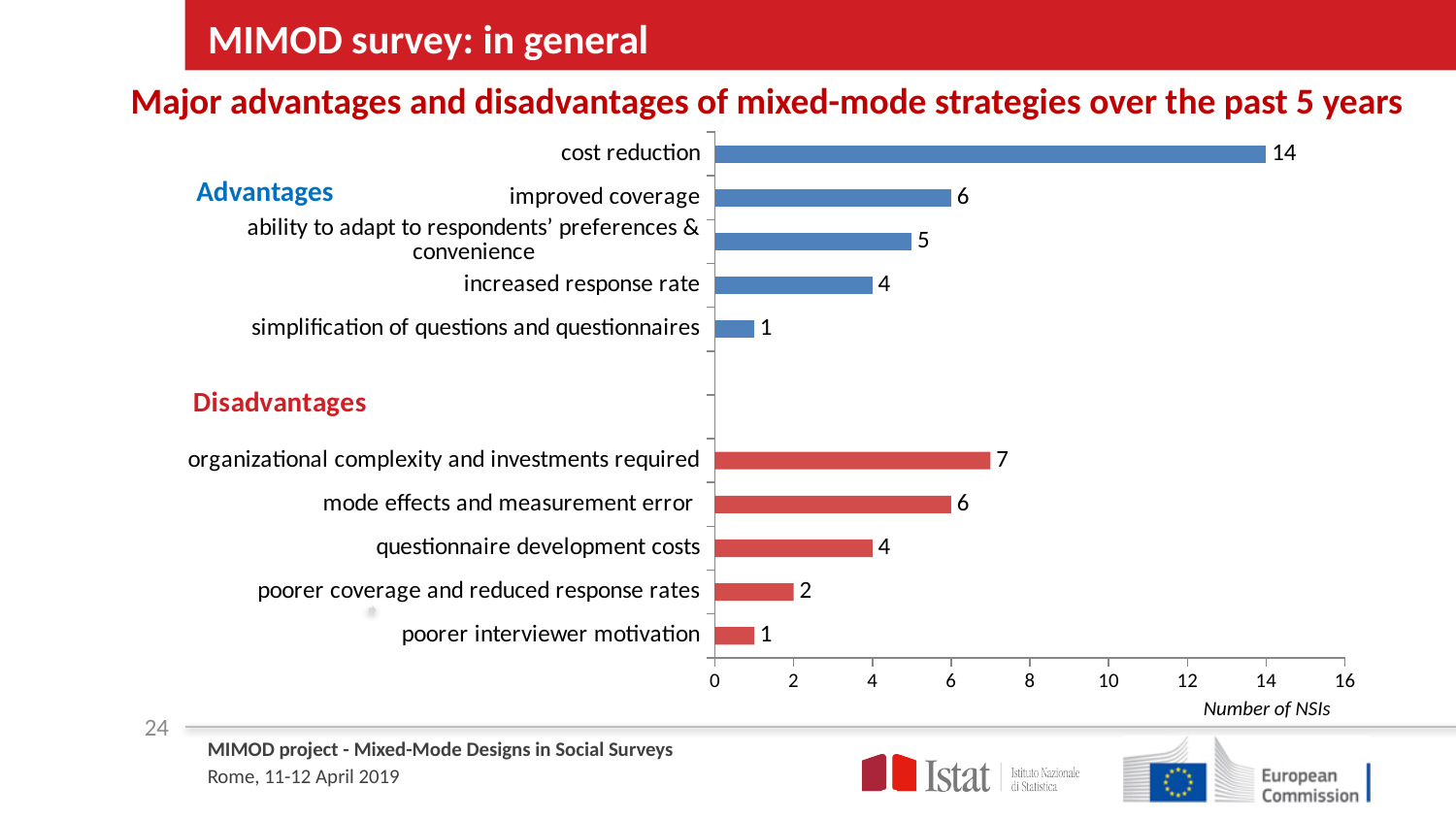
Which is larger, the value for mode effects and measurement error or the value for questionnaire development costs? mode effects and measurement error How many bars are plotted in the chart? 10 What is the value for ability to adapt to respondents' preferences & convenience? 5 What is the value for poorer coverage and reduced response rates? 2 What kind of chart is shown on the slide? bar chart What is the difference between the values for cost reduction and improved coverage? 8 What is the label on the horizontal axis of the chart? Number of NSIs What is the difference between the values for organizational complexity and investments required and poorer interviewer motivation? 6 Which category has the highest value in the chart? cost reduction What is the value for cost reduction? 14 What is the value for organizational complexity and investments required? 7 Which disadvantage has the highest value? organizational complexity and investments required